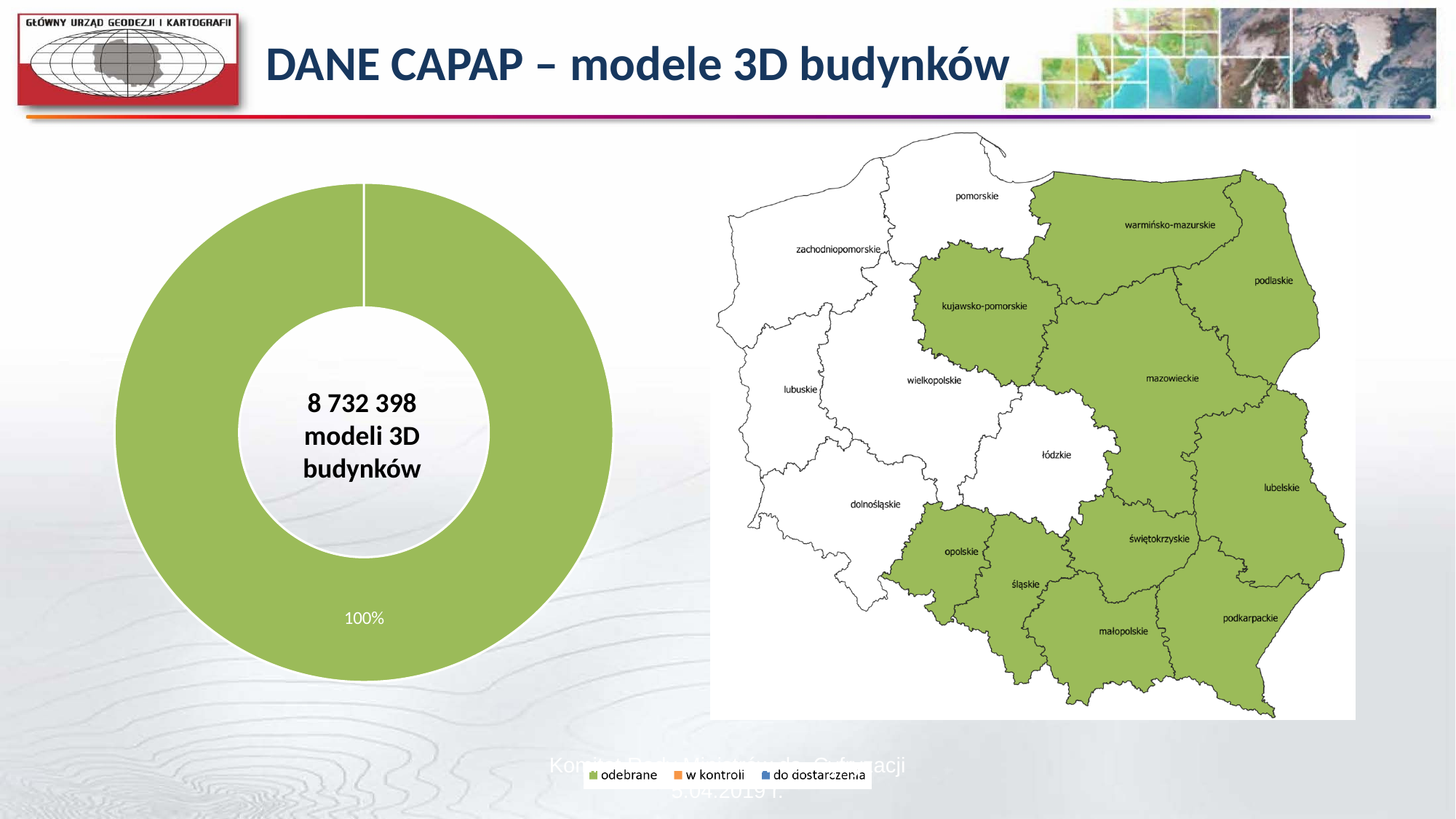
What kind of chart is shown on the left of the slide? doughnut (pie) chart In the doughnut chart, what share is labelled for the 'odebrane' category? 100% On the map of Poland, is the 'łódzkie' voivodeship shaded green or white? white On the map of Poland, is the 'mazowieckie' voivodeship shaded green or white? green How many entries does the legend of the doughnut chart list? 3 How many slices are visible in the doughnut chart? 1 On the map of Poland, how many voivodeships are shaded green? 10 Which category accounts for the largest share of the doughnut chart? odebrane What number of 3D building models is printed in the centre of the doughnut chart? 8 732 398 Which legend entry of the doughnut chart is shown in orange? w kontroli What colour represents 'odebrane' in the doughnut chart legend? green On the map of Poland, how many voivodeships are left white (unshaded)? 6